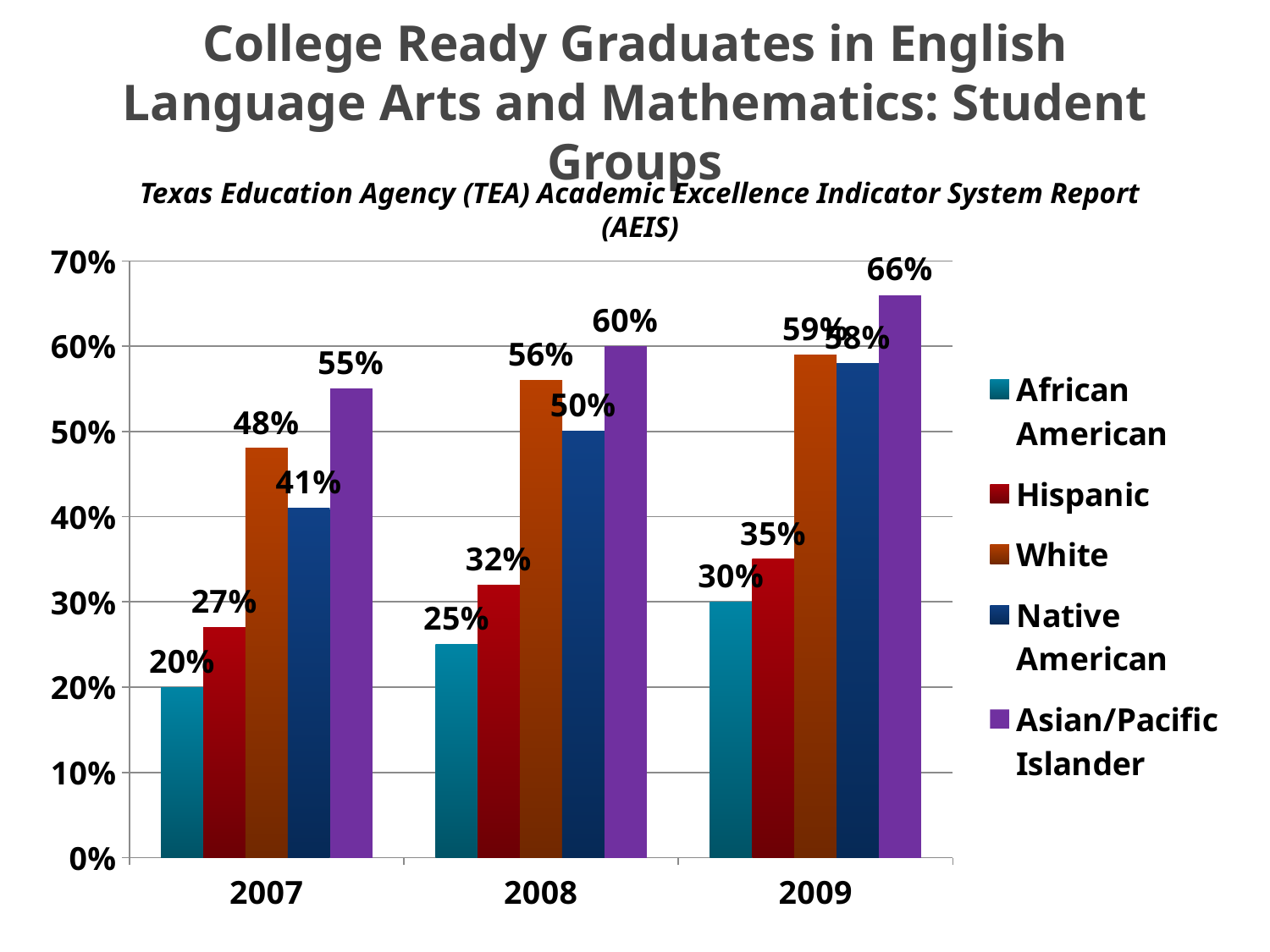
Which student group has the lowest value in 2009? African American Which is larger in 2008: the Native American value or the Hispanic value? Native American Which student group has the highest value in 2008? Asian/Pacific Islander What kind of chart is shown on the slide? bar chart What is the value for African American students in 2007? 20% What is the value for White students in 2008? 56% Is the value for Native American students in 2009 greater or less than 50%? greater How many years are shown on the x axis? 3 What is the value for Asian/Pacific Islander students in 2009? 66% What is the difference between the Asian/Pacific Islander value and the Hispanic value in 2007? 28% Do the values for African American students rise or fall from 2007 to 2009? rise How many series does the legend list? 5